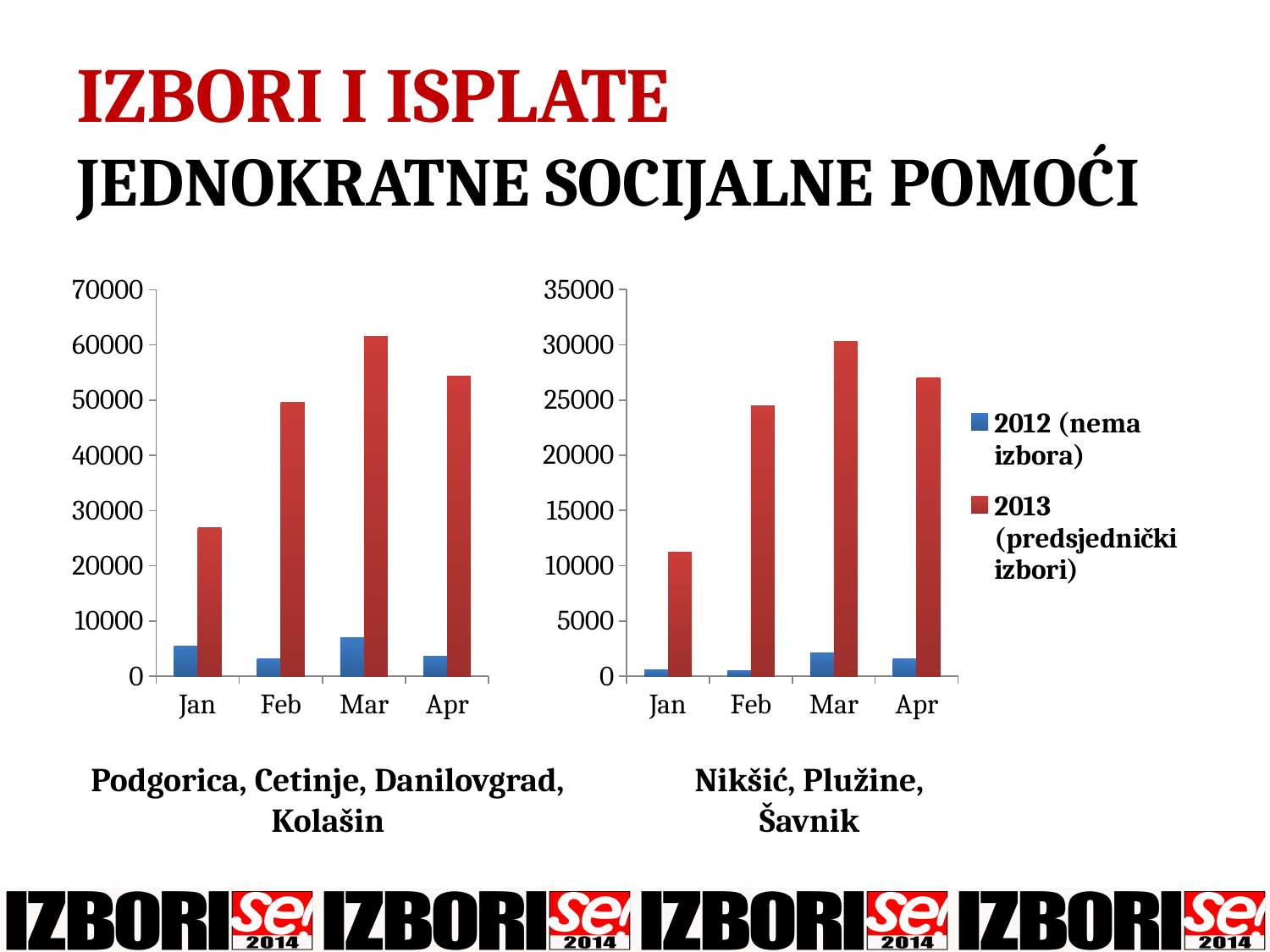
In the right chart (Nikšić, Plužine, Šavnik), which is larger for Apr: the 2012 value or the 2013 value? 2013 How many months are shown on the x axis of the left chart (Podgorica, Cetinje, Danilovgrad, Kolašin)? 4 In the right chart (Nikšić, Plužine, Šavnik), which month has the lowest value for the 2013 (predsjednički izbori) series? Jan In the left chart (Podgorica, Cetinje, Danilovgrad, Kolašin), which month has the highest value for the 2013 (predsjednički izbori) series? Mar In the left chart (Podgorica, Cetinje, Danilovgrad, Kolašin), which month has the lowest value for the 2013 (predsjednički izbori) series? Jan How many series does the legend list for the charts on the slide? 2 In the left chart (Podgorica, Cetinje, Danilovgrad, Kolašin), which is larger for Feb: the 2012 value or the 2013 value? 2013 In the left chart (Podgorica, Cetinje, Danilovgrad, Kolašin), is the 2013 value for Jan greater or less than 30000? less In the right chart (Nikšić, Plužine, Šavnik), which month has the highest value for the 2013 (predsjednički izbori) series? Mar In the left chart (Podgorica, Cetinje, Danilovgrad, Kolašin), is the 2013 value for Mar greater or less than 60000? greater